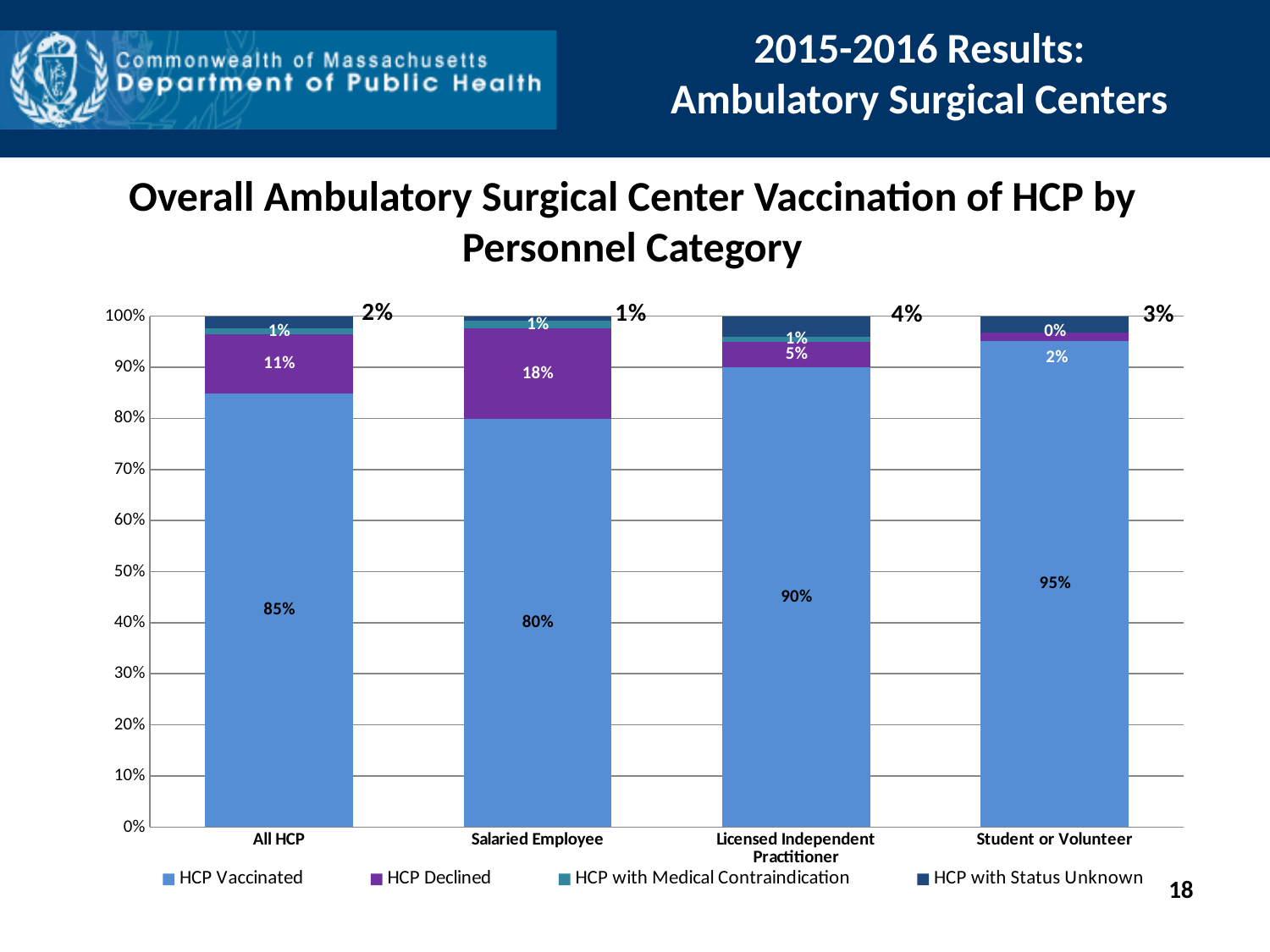
What is the HCP Declined value for Licensed Independent Practitioner? 5% Which personnel category has the lowest HCP Vaccinated value? Salaried Employee How many personnel categories are shown on the x axis? 4 What is the HCP Vaccinated value for Salaried Employee? 80% Which is larger, the HCP Declined value for All HCP or for Licensed Independent Practitioner? All HCP What is the HCP Vaccinated value for All HCP? 85% What type of chart is shown on the slide? Stacked bar chart What is the title of the chart? Overall Ambulatory Surgical Center Vaccination of HCP by Personnel Category How many series does the legend list? 4 What is the HCP Declined value for Salaried Employee? 18% Which personnel category has the highest HCP Vaccinated value? Student or Volunteer What is the difference between the HCP Vaccinated values for Student or Volunteer and Salaried Employee? 15%